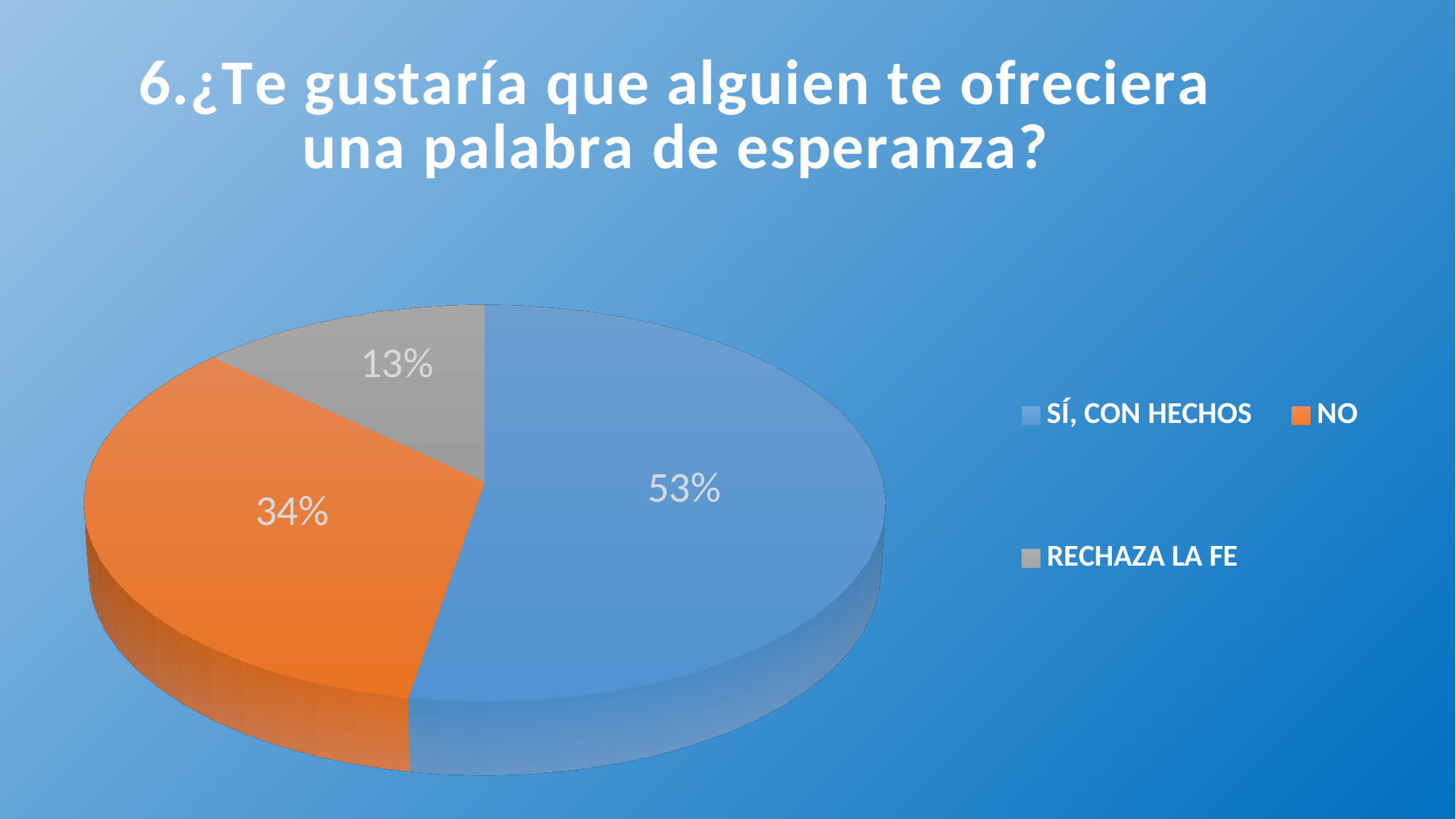
How many slices does the pie chart have? 3 What is the difference in percentage points between "NO" and "RECHAZA LA FE"? 21 What percentage of the pie is labelled "RECHAZA LA FE"? 13% What is the difference in percentage points between "SÍ, CON HECHOS" and "NO"? 19 What colour is the slice for "NO"? Orange What kind of chart is shown on the slide? Pie chart How many entries does the legend list? 3 What percentage of the pie is labelled "SÍ, CON HECHOS"? 53% Which category has the smallest share of the pie? RECHAZA LA FE Which category has the largest share of the pie? SÍ, CON HECHOS What percentage of the pie is labelled "NO"? 34% Which is larger, the share for "NO" or the share for "RECHAZA LA FE"? NO